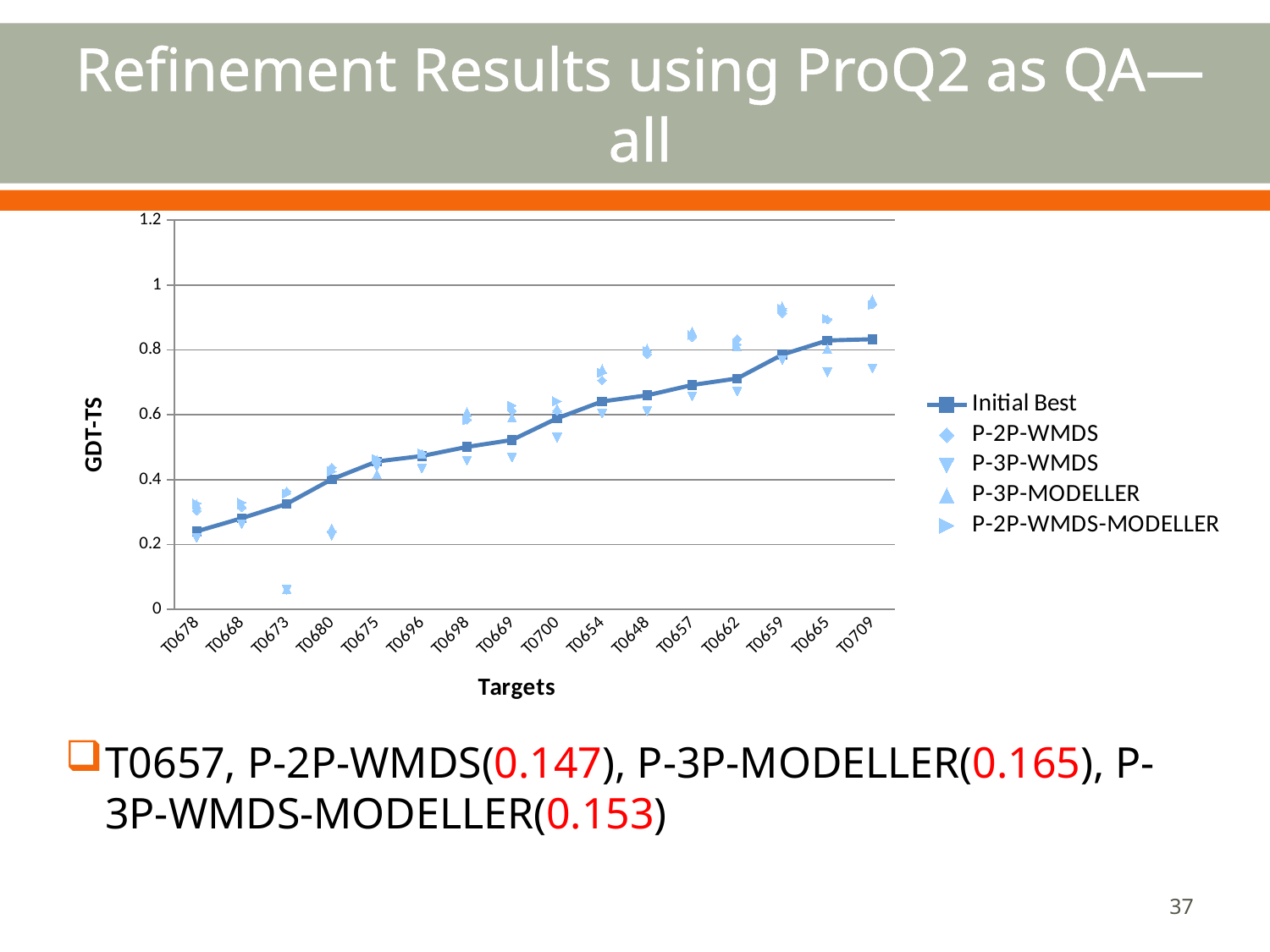
What kind of chart is shown on the slide? line chart How many targets are shown on the x axis of the chart? 16 What is the label of the x axis of the chart? Targets Which is larger, the Initial Best value for T0665 or for T0678? T0665 Is the Initial Best value for T0662 greater or less than 0.8? less Is the Initial Best value for T0678 greater or less than 0.4? less Is the Initial Best value for T0709 greater or less than 0.8? greater Does the Initial Best line rise or fall from T0678 to T0709? rise How many series does the chart legend list? 5 What is the label of the y axis of the chart? GDT-TS Which target has the lowest Initial Best value? T0678